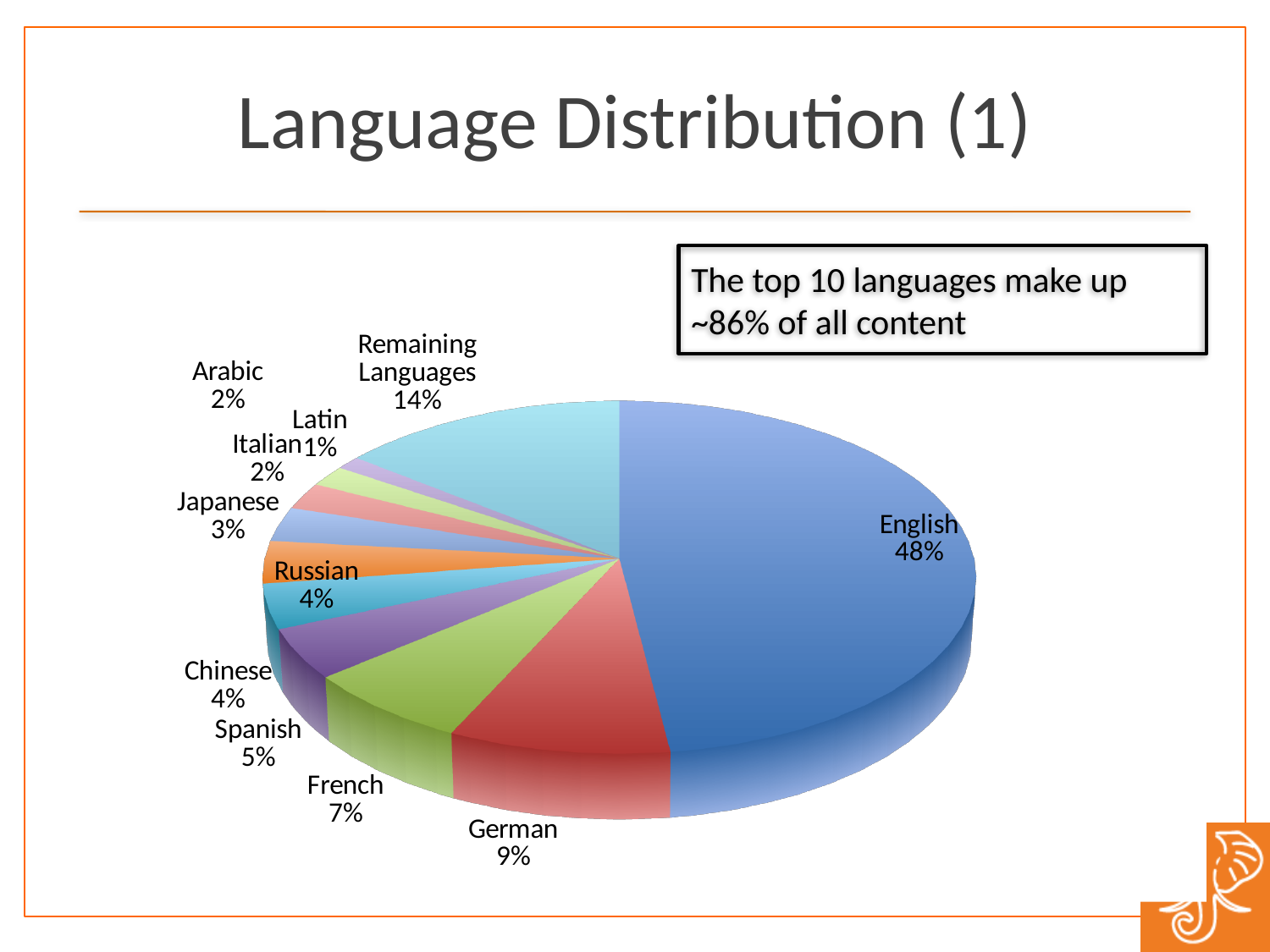
What is the value for German? 9% Which language has the largest slice? English What is the difference between the Russian and Latin shares? 3% What is the value for Remaining Languages? 14% What is the value for Japanese? 3% How many slices does the pie chart have? 11 What is the title of the slide containing the chart? Language Distribution (1) Which is larger, French or Spanish? French What is the difference between the English and German shares? 39% What share of the pie does English have? 48% Which category has the smallest slice? Latin What kind of chart is shown on the slide? Pie chart